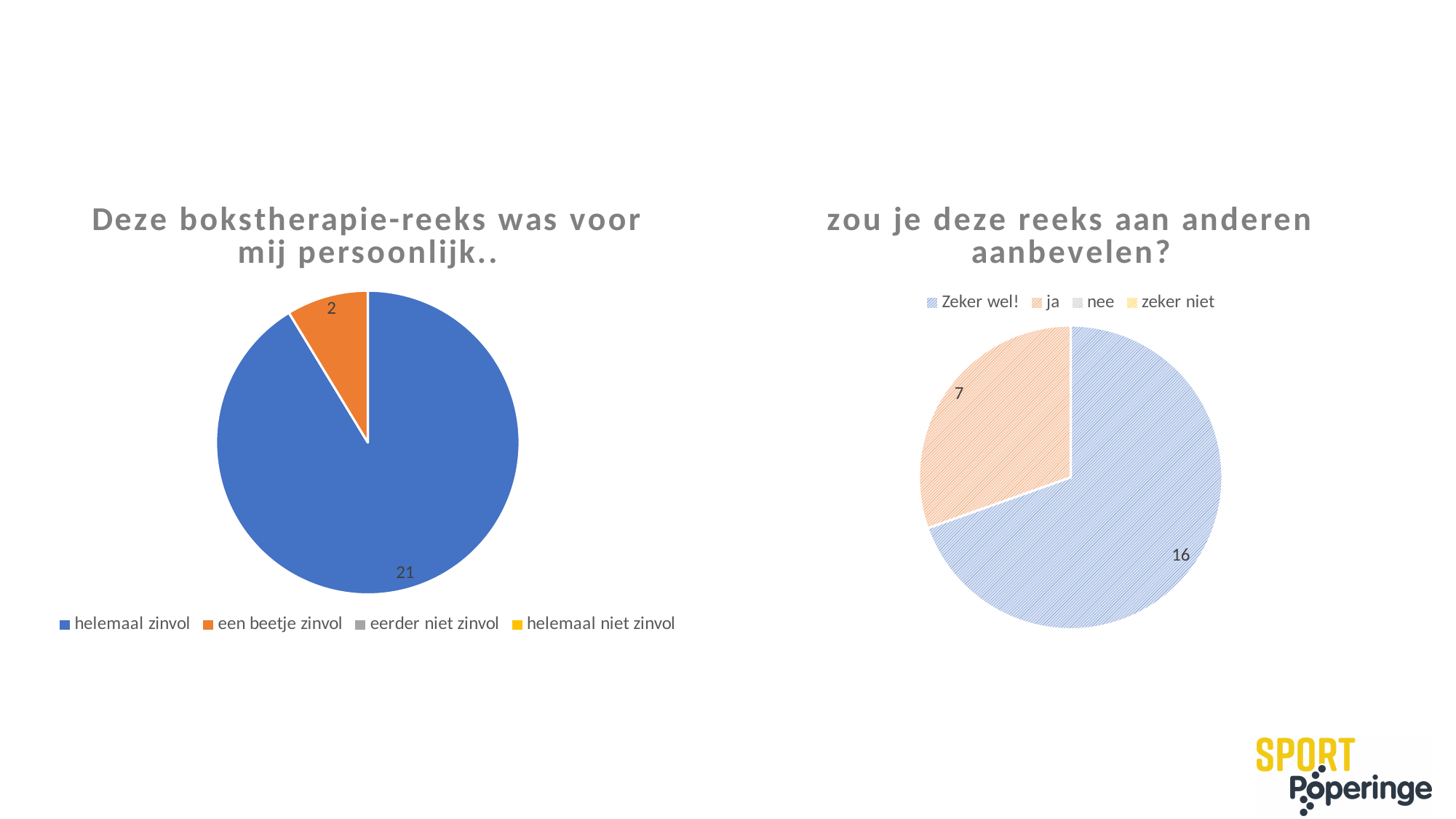
In the chart titled "zou je deze reeks aan anderen aanbevelen?", what is the value for "Zeker wel!"? 16 What type of chart is the left chart? pie chart In the chart titled "Deze bokstherapie-reeks was voor mij persoonlijk..", what is the value for "helemaal zinvol"? 21 How many entries does the legend of the right chart list? 4 In the left chart, what is the difference between the values for "helemaal zinvol" and "een beetje zinvol"? 19 In the left chart, which category has the largest slice? helemaal zinvol In the right chart, what is the difference between the values for "Zeker wel!" and "ja"? 9 In the chart titled "Deze bokstherapie-reeks was voor mij persoonlijk..", what is the value for "een beetje zinvol"? 2 In the chart titled "zou je deze reeks aan anderen aanbevelen?", what is the value for "ja"? 7 In the right chart, which category has the largest slice? Zeker wel! What is the title of the right chart? zou je deze reeks aan anderen aanbevelen? In the right chart, which is larger: "Zeker wel!" or "ja"? Zeker wel!